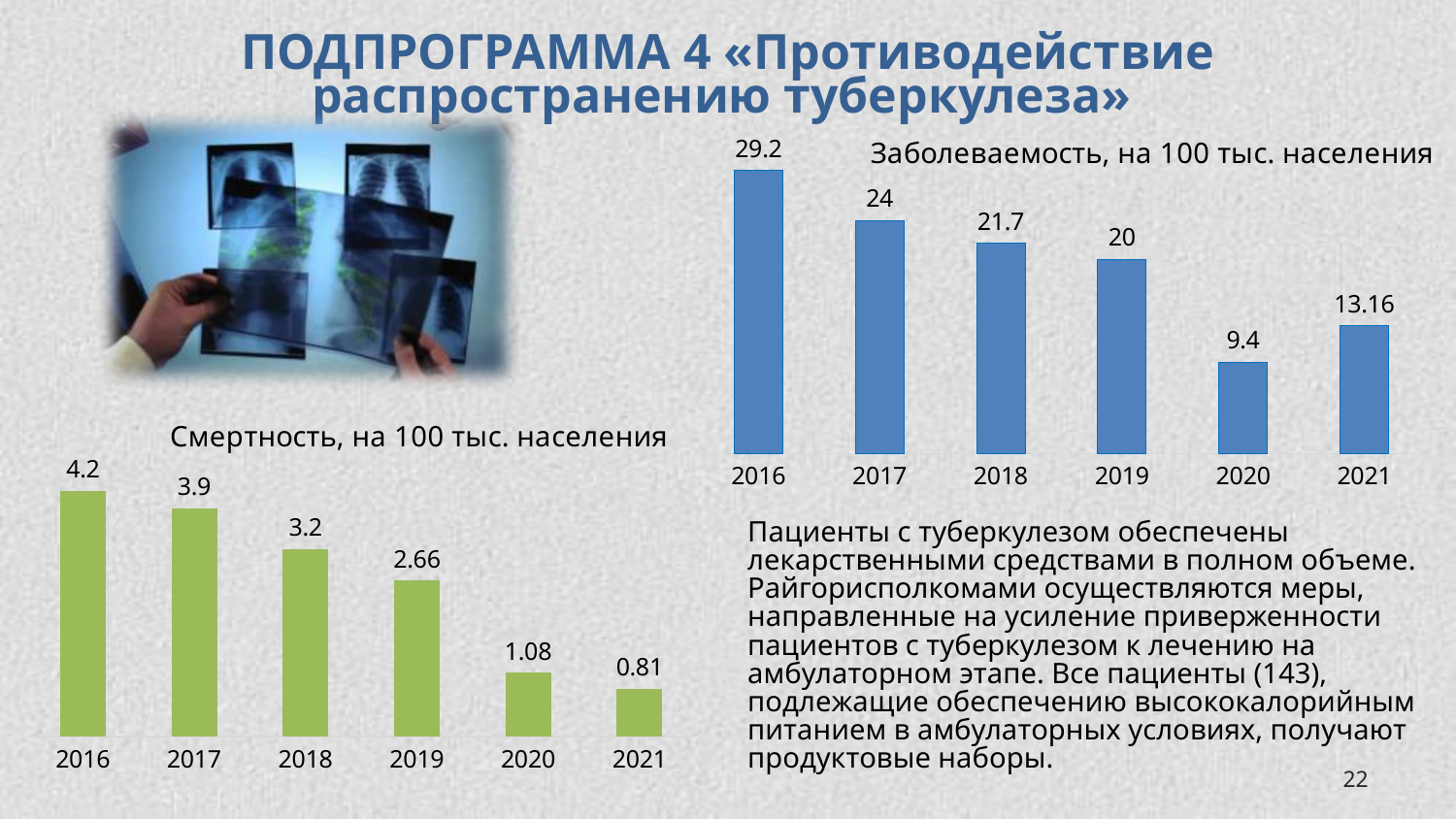
In the chart titled «Заболеваемость, на 100 тыс. населения», how many years are shown? 6 What kind of chart is the chart titled «Смертность, на 100 тыс. населения»? bar chart In the chart titled «Смертность, на 100 тыс. населения», what is the difference between the values for 2020 and 2021? 0.27 In the chart titled «Заболеваемость, на 100 тыс. населения», which year has the lowest value? 2020 In the chart titled «Заболеваемость, на 100 тыс. населения», what is the value for 2021? 13.16 In the chart titled «Смертность, на 100 тыс. населения», which year has the highest value? 2016 In the chart titled «Смертность, на 100 тыс. населения», what is the value for 2019? 2.66 In the chart titled «Заболеваемость, на 100 тыс. населения», which is larger, the value for 2020 or the value for 2021? 2021 In the chart titled «Смертность, на 100 тыс. населения», do the values rise or fall from 2016 to 2021? fall In the chart titled «Заболеваемость, на 100 тыс. населения», what is the difference between the values for 2016 and 2017? 5.2 In the chart titled «Заболеваемость, на 100 тыс. населения», what is the value for 2016? 29.2 In the chart titled «Смертность, на 100 тыс. населения», what is the value for 2021? 0.81